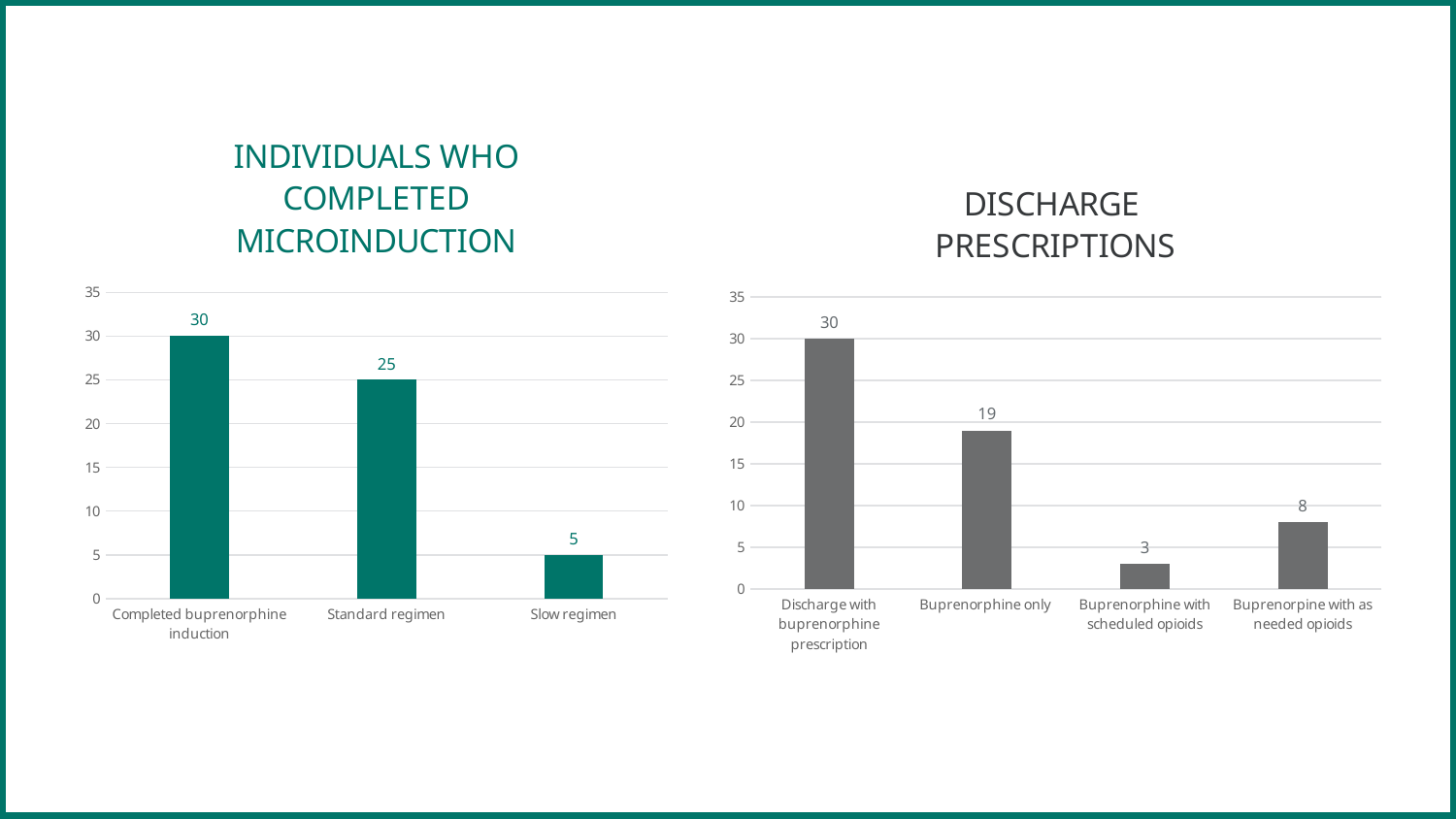
What type of chart is the 'Discharge prescriptions' chart? bar chart In the 'Individuals who completed microinduction' chart, how many categories are shown? 3 In the 'Individuals who completed microinduction' chart, which category has the lowest value? Slow regimen In the 'Individuals who completed microinduction' chart, do the values rise or fall from left to right? fall In the 'Individuals who completed microinduction' chart, what is the value for Standard regimen? 25 In the 'Discharge prescriptions' chart, how many categories are shown? 4 In the 'Discharge prescriptions' chart, which category has the highest value? Discharge with buprenorphine prescription In the 'Discharge prescriptions' chart, what is the value for Buprenorphine only? 19 In the 'Discharge prescriptions' chart, what is the difference between Discharge with buprenorphine prescription and Buprenorphine only? 11 In the 'Discharge prescriptions' chart, which is larger: Buprenorphine with scheduled opioids or Buprenorpine with as needed opioids? Buprenorpine with as needed opioids In the 'Discharge prescriptions' chart, what is the value for Buprenorphine with scheduled opioids? 3 In the 'Individuals who completed microinduction' chart, what is the difference between Completed buprenorphine induction and Slow regimen? 25